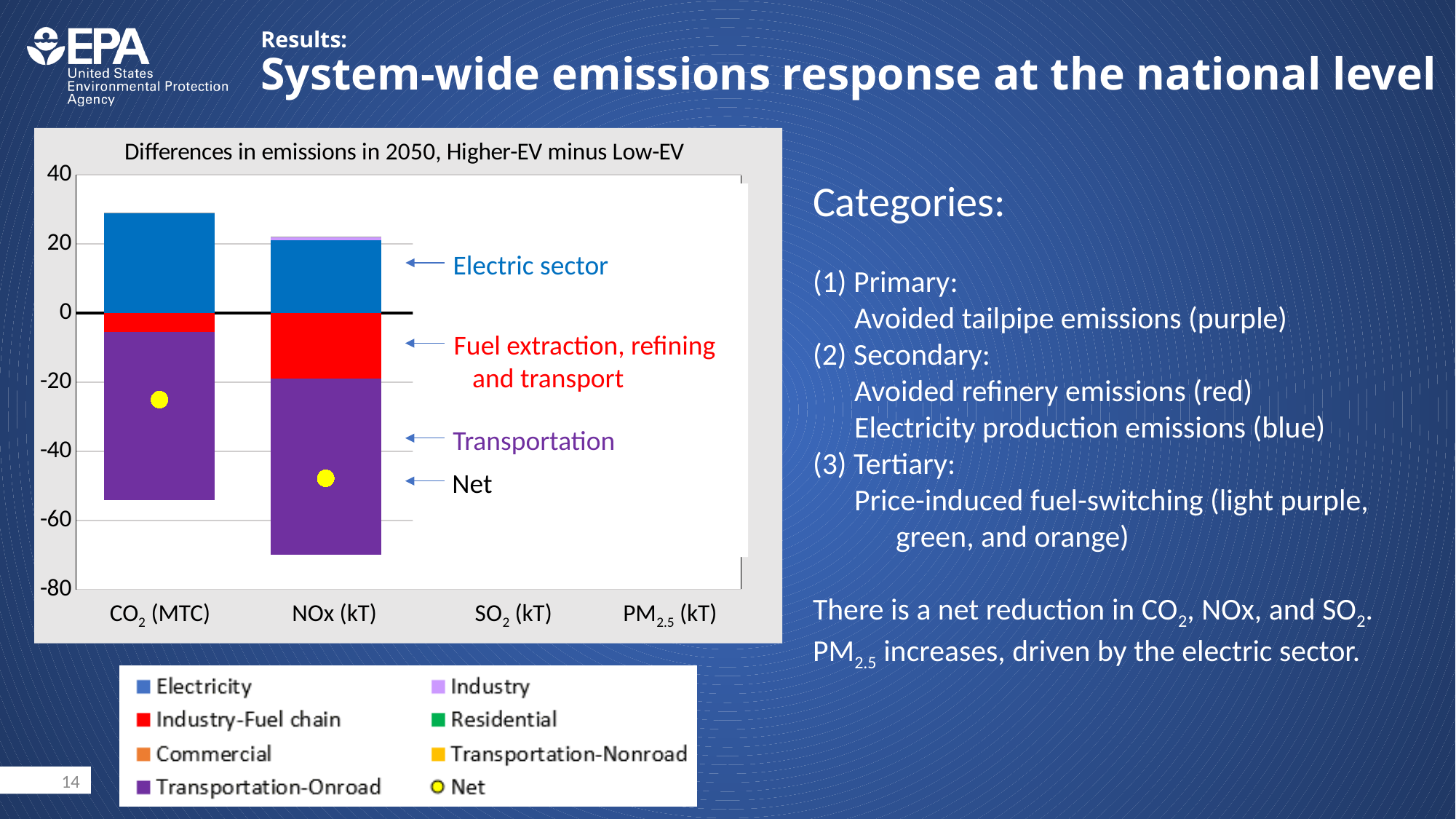
What kind of chart is shown on the slide? Stacked bar chart Which category has the larger Industry-Fuel chain reduction, CO2 (MTC) or NOx (kT)? NOx (kT) What marker is used to show the Net value in the chart? A yellow circle Which category has the larger Electricity segment, CO2 (MTC) or NOx (kT)? CO2 (MTC) How many categories are labelled on the x axis of the chart? 4 Which category has the lower Net value, CO2 (MTC) or NOx (kT)? NOx (kT) What is the title of the chart? Differences in emissions in 2050, Higher-EV minus Low-EV Is the Net value for CO2 (MTC) greater or less than -20? less Is the Electricity value for CO2 (MTC) greater or less than 20? greater How many entries does the chart legend list? 8 Is the Transportation-Onroad value for NOx (kT) greater or less than -60? greater